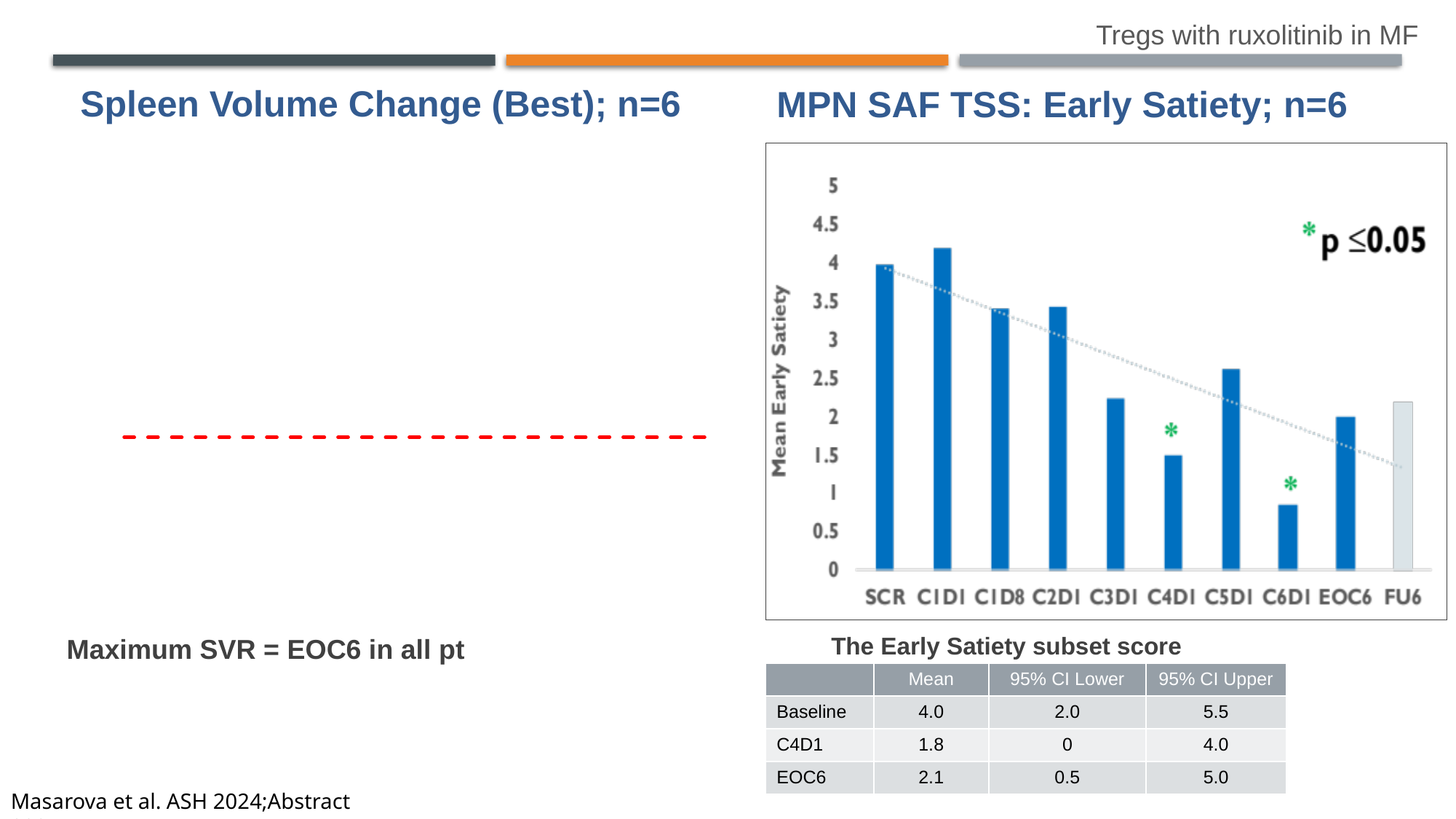
In the MPN SAF TSS: Early Satiety chart, how many time points (categories) are plotted on the x axis? 10 In the MPN SAF TSS: Early Satiety chart, is the value for C5D1 greater or less than 2? greater In the MPN SAF TSS: Early Satiety chart, which is larger, the value for C3D1 or the value for C5D1? C5D1 In the MPN SAF TSS: Early Satiety chart, which time points are marked with an asterisk (p ≤0.05)? C4D1 and C6D1 In the MPN SAF TSS: Early Satiety chart, is the value for C6D1 greater or less than 1? less In the MPN SAF TSS: Early Satiety chart, is the value for C4D1 greater or less than 2? less In the MPN SAF TSS: Early Satiety chart, which time point has the lowest mean early satiety? C6D1 In the MPN SAF TSS: Early Satiety chart, which time point has the highest mean early satiety? C1D1 What is the y-axis label of the MPN SAF TSS: Early Satiety chart? Mean Early Satiety In the MPN SAF TSS: Early Satiety chart, do the values generally rise or fall from SCR to FU6? fall What kind of chart is shown under the title "MPN SAF TSS: Early Satiety; n=6"? bar chart